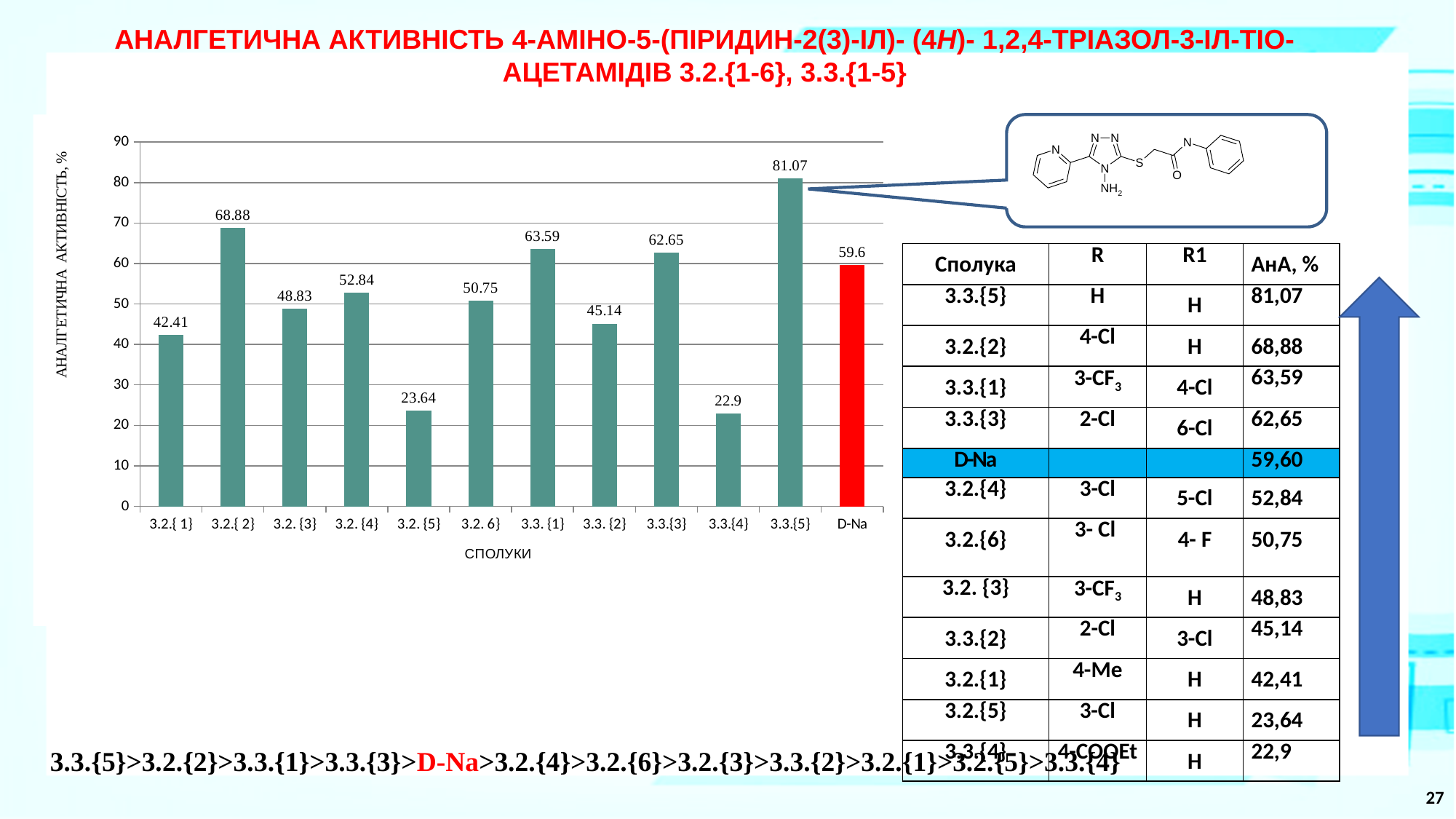
What is the value for 3.3.{5} in the bar chart? 81.07 Which compound has the lowest value in the bar chart? 3.3.{4} What is the difference between the values for 3.3.{5} and D-Na? 21.47 Is the value for 3.2.{5} greater or less than 30? less Which compound has the highest value in the bar chart? 3.3.{5} Which bar in the chart is coloured red? D-Na What is the value for D-Na in the bar chart? 59.6 What kind of chart is shown on the slide? bar chart How many compounds are shown on the x axis of the bar chart? 12 What is the difference between the values for 3.2.{2} and 3.3.{3}? 6.23 Which is larger, the value for 3.2.{2} or the value for 3.3.{1}? 3.2.{2} What is the value for 3.2.{5} in the bar chart? 23.64